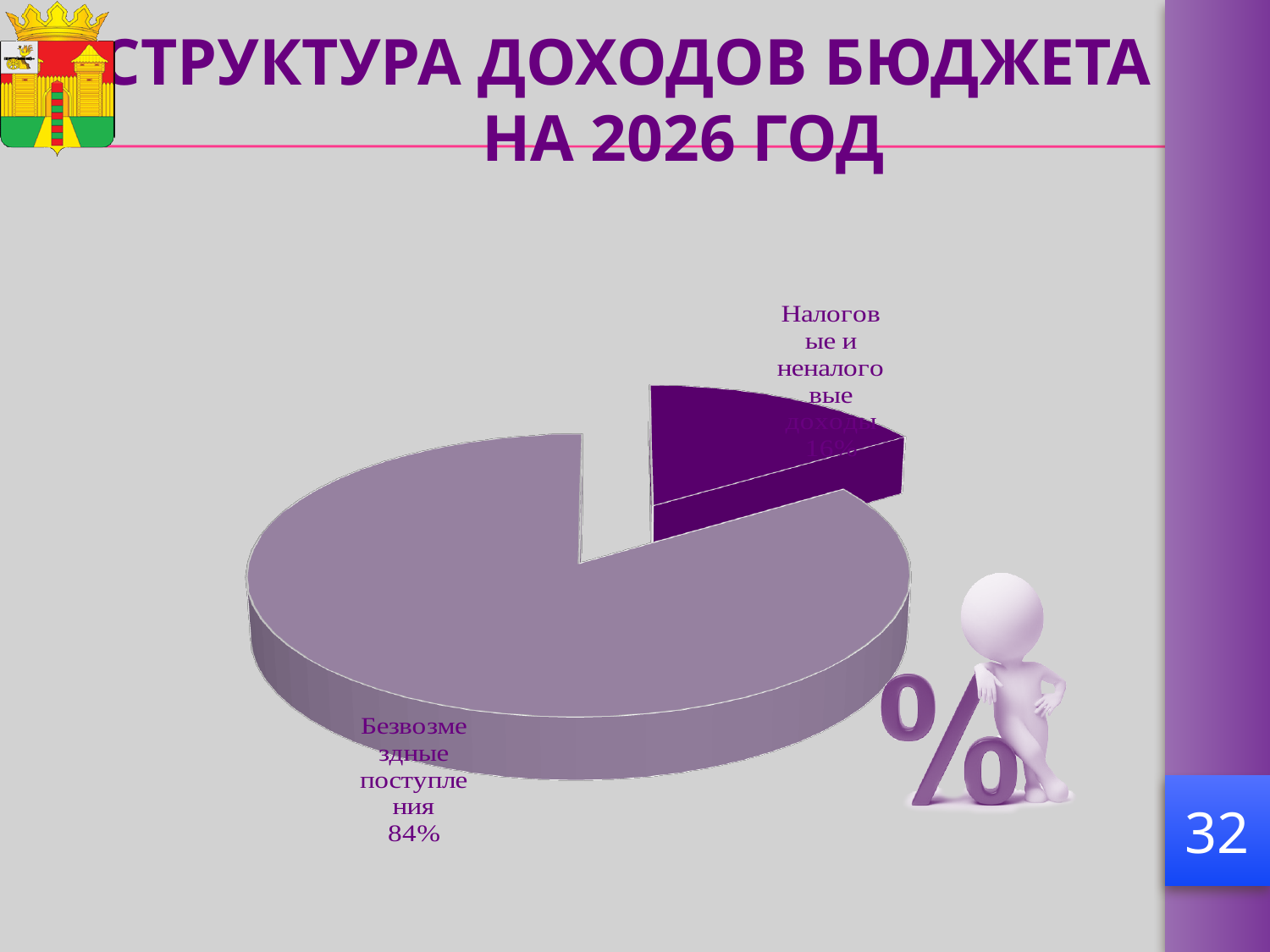
What is the title of the slide containing the pie chart? СТРУКТУРА ДОХОДОВ БЮДЖЕТА НА 2026 ГОД What share of the pie does "Безвозмездные поступления" take? 84% Which is larger: "Безвозмездные поступления" or "Налоговые и неналоговые доходы"? Безвозмездные поступления Which category has the smallest slice of the pie? Налоговые и неналоговые доходы Which category has the largest slice of the pie? Безвозмездные поступления What kind of chart is shown on the slide? pie chart How many slices does the pie chart have? 2 What colour is the slice for "Налоговые и неналоговые доходы"? dark purple